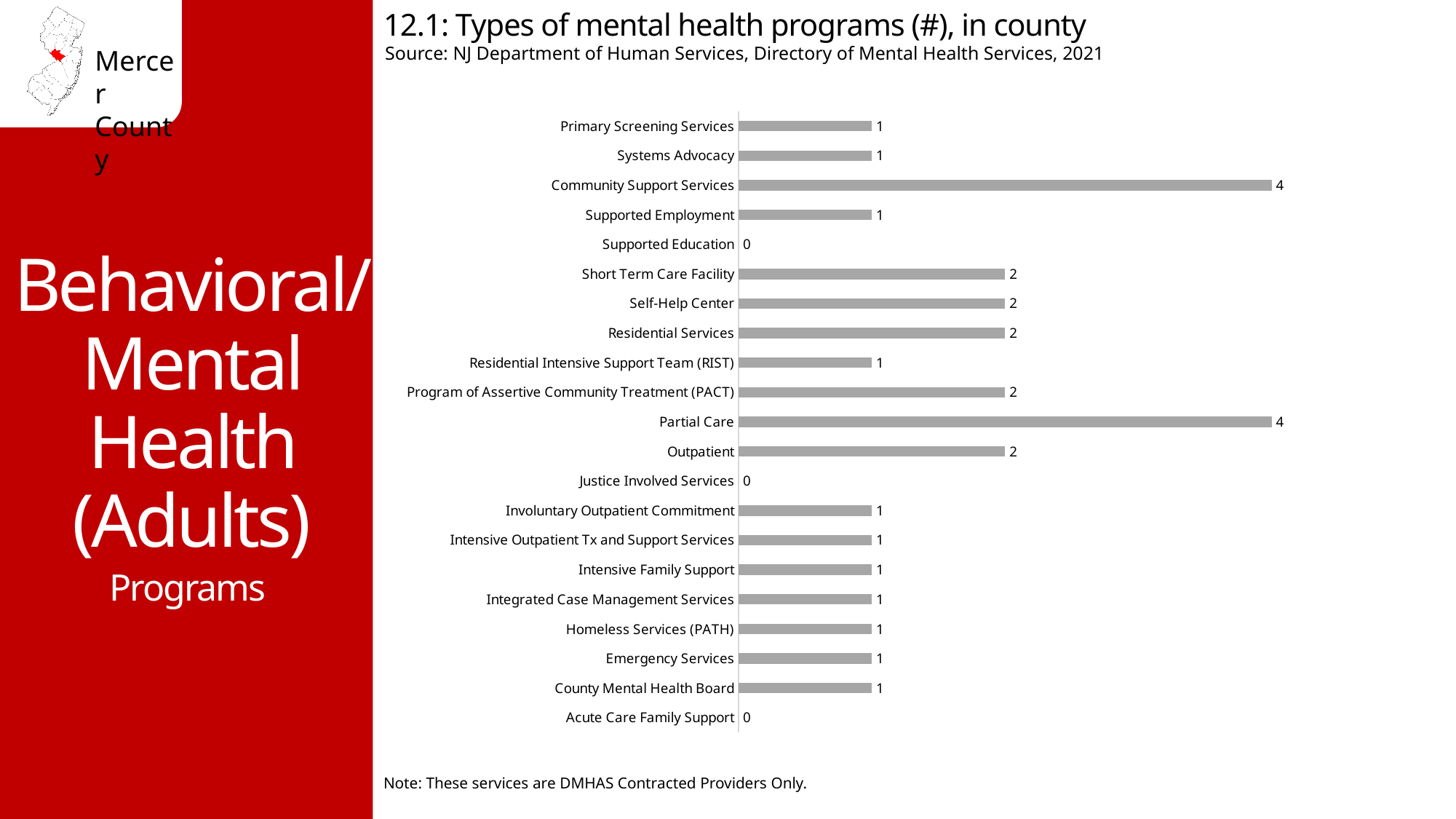
What is the value for Supported Education? 0 What is the value for Partial Care? 4 What kind of chart is shown on the slide? Bar chart How many categories have a value of 0? 3 What is the highest value shown in the chart? 4 How many categories are shown in the chart? 21 Which is larger, the value for Self-Help Center or the value for Systems Advocacy? Self-Help Center What is the difference between the values for Partial Care and Outpatient? 2 What is the value for Short Term Care Facility? 2 What is the source cited for the chart? NJ Department of Human Services, Directory of Mental Health Services, 2021 What is the value for Community Support Services? 4 What is the value for Homeless Services (PATH)? 1